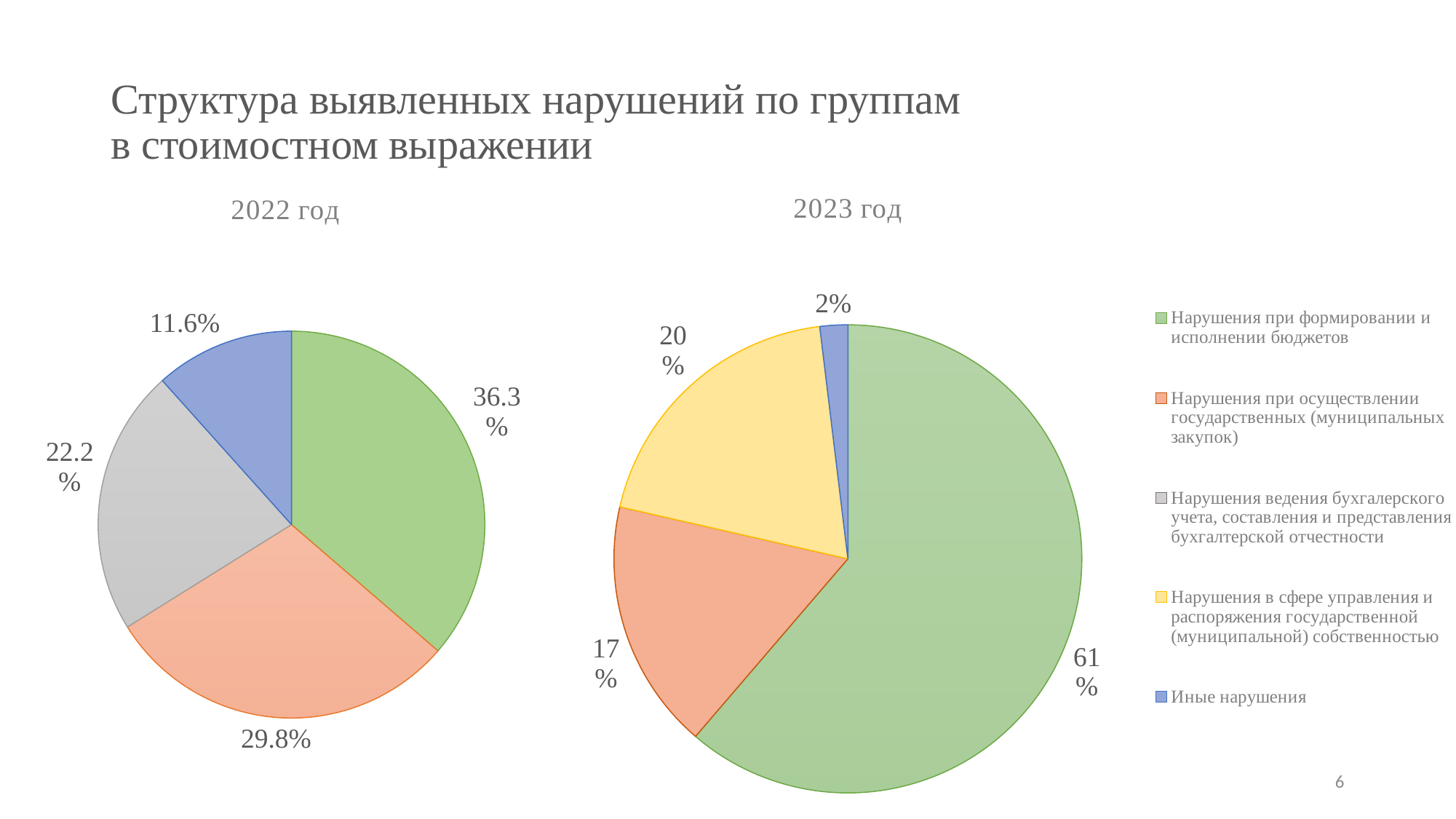
In the 2022 год pie chart, what share is shown for Иные нарушения (blue slice)? 11.6% How many entries does the legend list? 5 In the 2022 год pie chart, which category has the largest slice? Нарушения при формировании и исполнении бюджетов In the 2023 год pie chart, what share is shown for Нарушения в сфере управления и распоряжения государственной (муниципальной) собственностью (yellow slice)? 20% What type of chart is used for the 2023 год data? Pie chart In the 2023 год pie chart, which category has the smallest slice? Иные нарушения In the 2023 год pie chart, what share is shown for Нарушения при формировании и исполнении бюджетов (green slice)? 61% In the 2022 год pie chart, which is larger: the orange slice (закупки) or the grey slice (бухгалтерский учет)? The orange slice (29.8%) In the 2023 год pie chart, what is the difference between the green slice (61%) and the orange slice (17%)? 44%